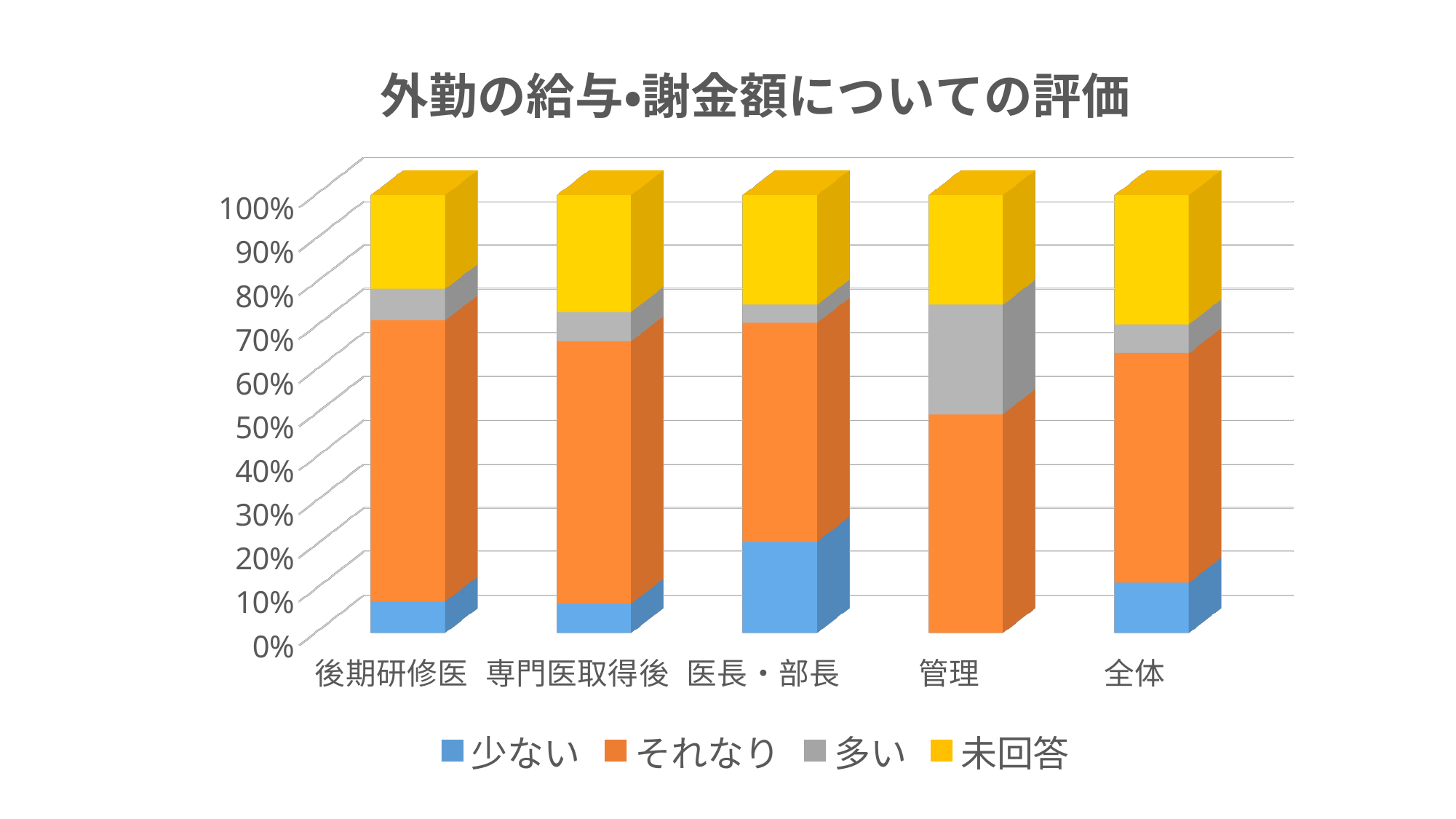
Is the それなり segment for 管理 greater or less than 60%? less What is the title of the chart? 外勤の給与•謝金額についての評価 What does each stacked bar total? 100% Which category has the largest 多い segment? 管理 How many series does the legend list? 4 How many categories are shown on the x axis? 5 Which category has the smallest 少ない segment? 管理 Is the 少ない segment for 医長・部長 greater or less than 10%? greater Which is larger, the 少ない segment for 医長・部長 or for 後期研修医? 医長・部長 Which category has the largest 少ない segment? 医長・部長 Which series is shown in blue in the legend? 少ない What kind of chart is shown on the slide? stacked bar chart